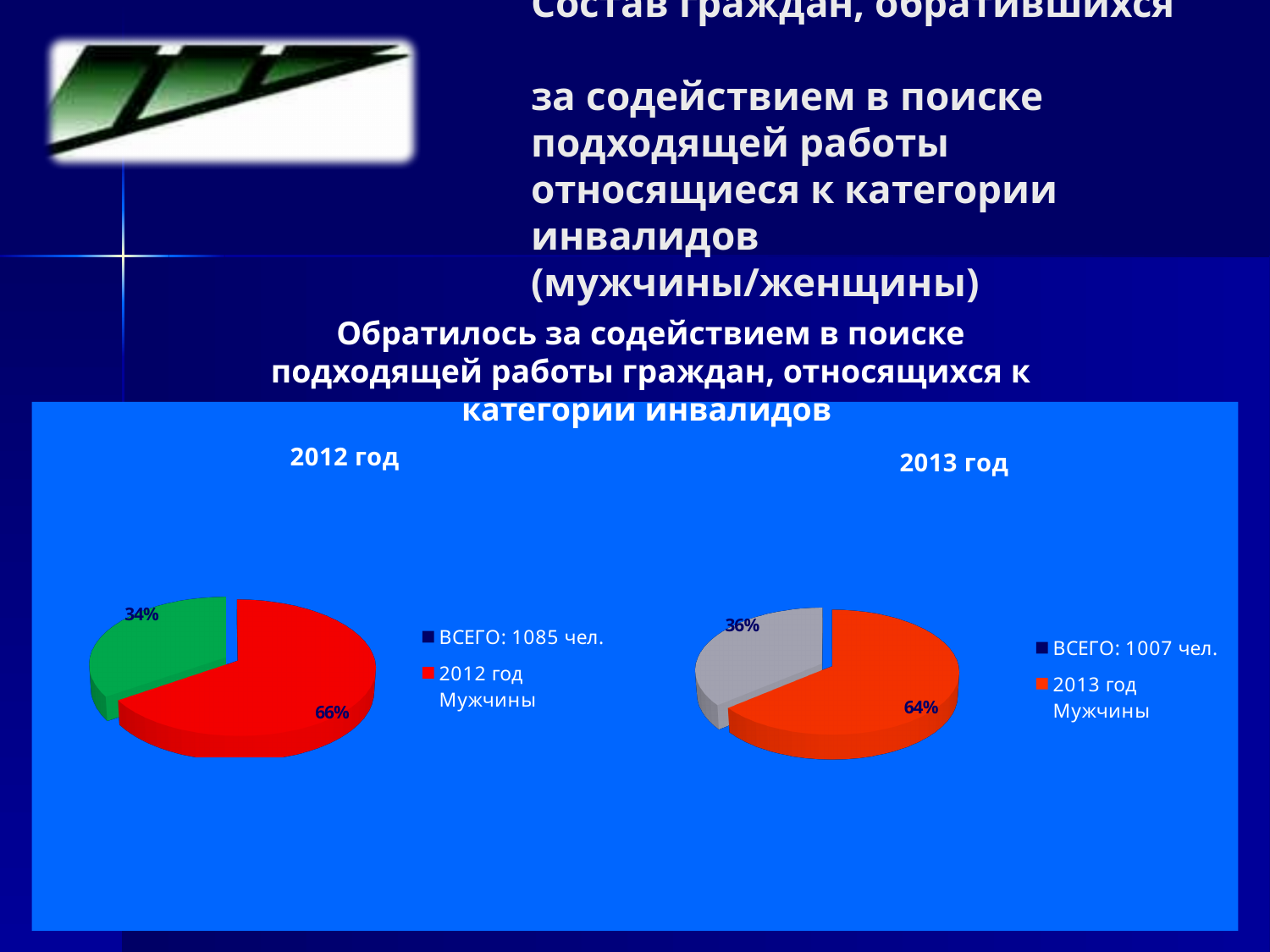
Which is larger: the Мужчины share in the 2012 год chart or the Мужчины share in the 2013 год chart? 2012 год (66%) In the 2013 год pie chart, what share is labelled for the Мужчины slice? 64% What type of chart is used for the 2012 год data? Pie chart In the 2013 год pie chart, which slice is the smallest? The grey slice (36%) In the 2012 год pie chart, what share is labelled for the Мужчины slice? 66% In the 2012 год pie chart, what percentage is shown on the green slice? 34% In the 2012 год pie chart, what is the difference in percentage points between the 66% slice and the 34% slice? 32 percentage points In the 2013 год pie chart, what percentage is shown on the grey slice? 36% How many slices does the 2013 год pie chart have? 2 What total number of people (ВСЕГО) is given in the legend of the 2013 год chart? 1007 чел. How many entries does the legend of the 2012 год chart list? 2 In the 2012 год pie chart, which slice is the largest? Мужчины (66%)